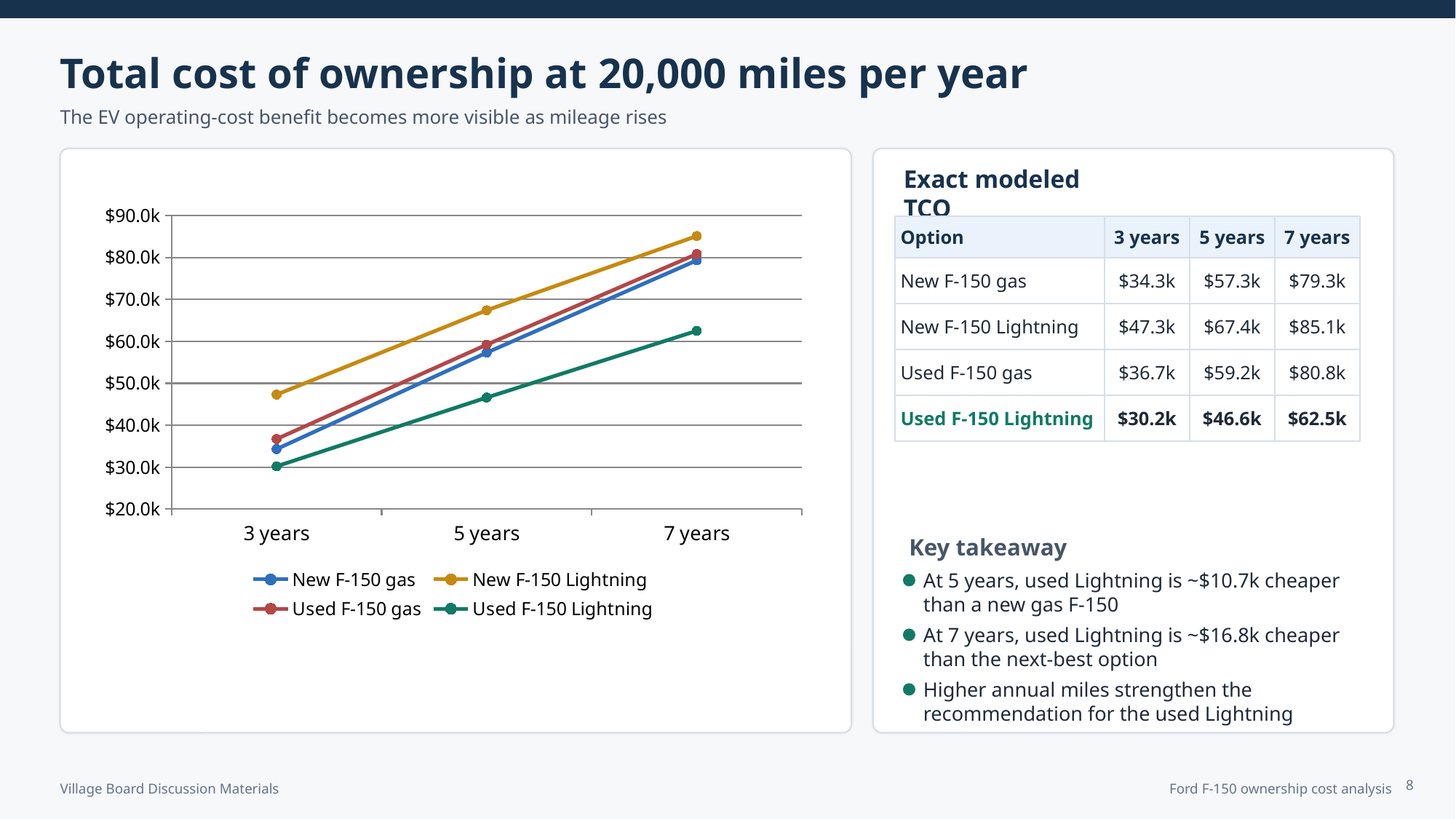
What is the modeled TCO for the Used F-150 Lightning at 5 years? $46.6k Do the total cost of ownership values rise or fall from 3 years to 7 years for every option? rise What kind of chart is shown on the slide? line chart How many series does the chart legend list? 4 What colour is the line for the Used F-150 Lightning in the chart? green Is the value for New F-150 Lightning at 3 years greater or less than $40.0k? greater What is the difference between the 7-year TCO of the New F-150 Lightning and the Used F-150 Lightning? $22.6k How many time points are plotted along the x axis of the chart? 3 Which option has the highest total cost of ownership at 7 years? New F-150 Lightning Which is larger at 5 years: the TCO for Used F-150 gas or for New F-150 gas? Used F-150 gas What is the modeled TCO for the New F-150 gas at 7 years? $79.3k Which option has the lowest total cost of ownership at 3 years? Used F-150 Lightning